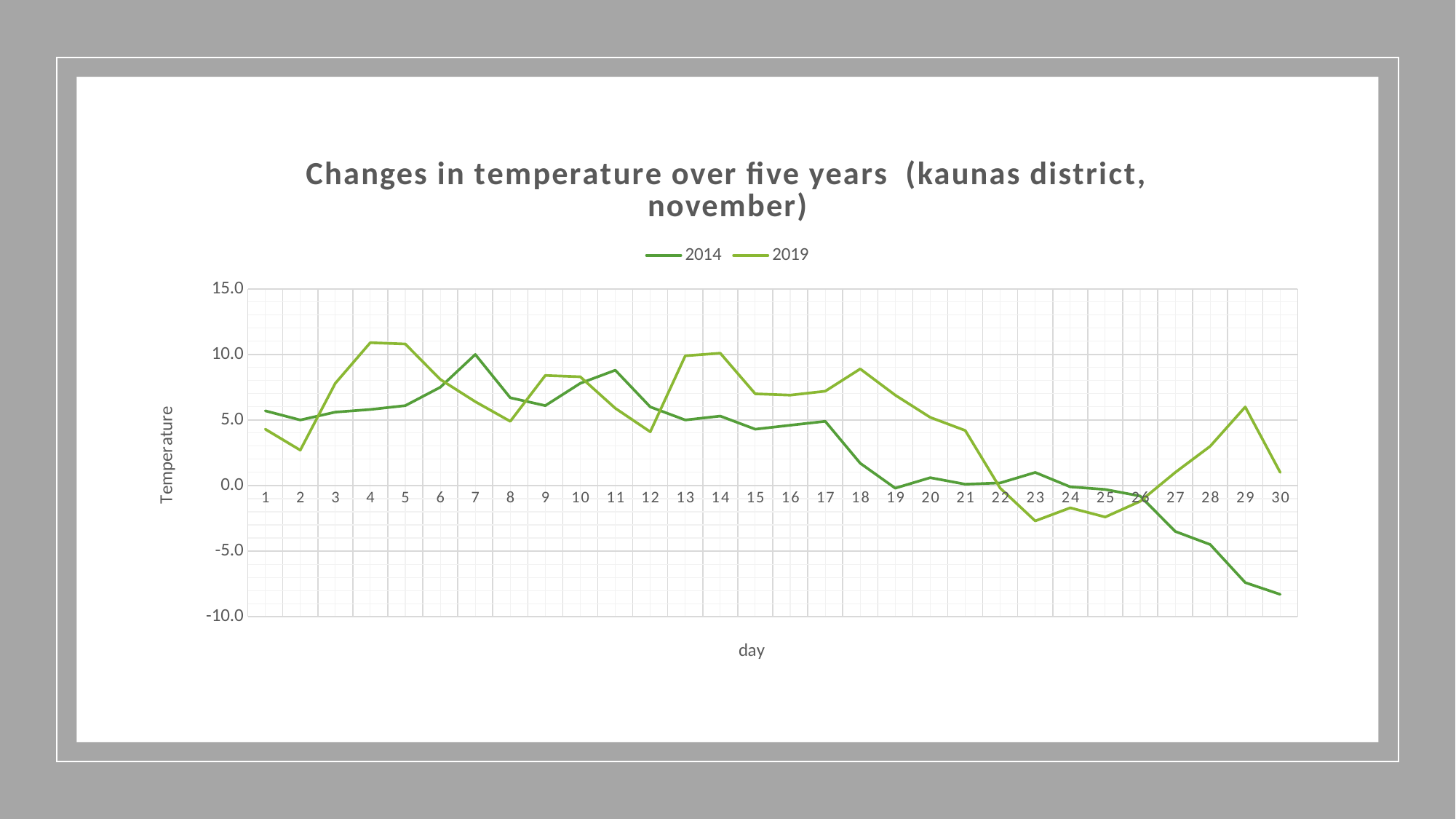
What kind of chart is shown on the slide? line chart How many series does the legend list? 2 On day 30, which series has the higher value, 2014 or 2019? 2019 Which series is the 2014 line's highest point on: which day? day 7 How many days are plotted along the x axis? 30 Does the 2014 series overall rise or fall from day 1 to day 30? fall On day 7, which series has the higher value, 2014 or 2019? 2014 On which day does the 2014 series reach its lowest value? day 30 Is the 2019 value on day 23 greater or less than 0.0? less Is the 2019 value on day 2 greater or less than 5.0? less Is the 2019 value on day 4 greater or less than 10.0? greater